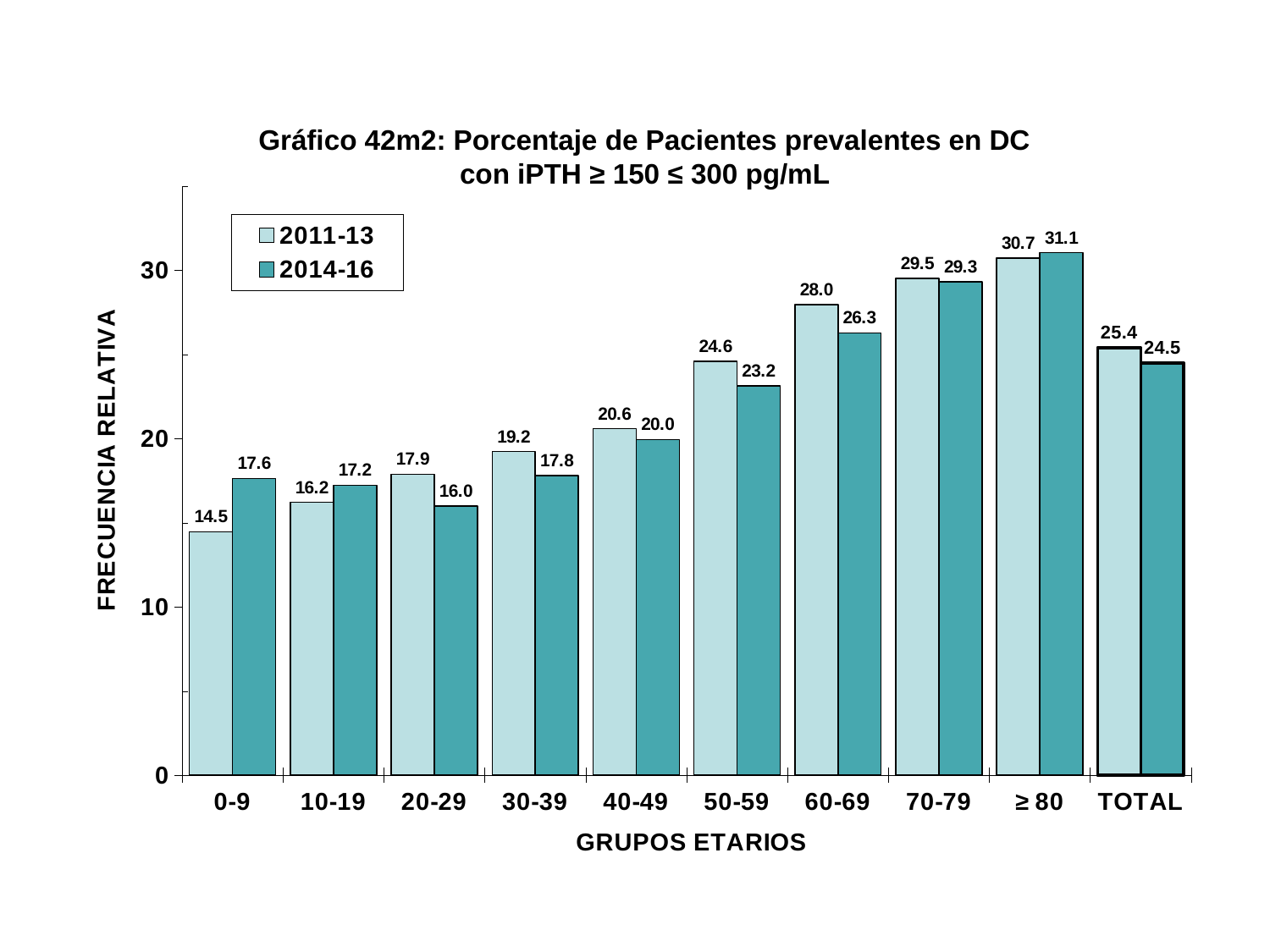
How many series does the legend list? 2 What is the value for the 2011-13 series in the 0-9 age group? 14.5 How many categories are shown on the x axis? 10 Is the 2014-16 value for the 40-49 age group greater or less than 10? greater What kind of chart is shown on the slide? bar chart What is the label of the y axis? FRECUENCIA RELATIVA Which age group has the lowest value for the 2011-13 series? 0-9 What is the TOTAL value for the 2014-16 series? 24.5 What is the difference between the 2011-13 and 2014-16 values in the 50-59 age group? 1.4 What is the value for the 2014-16 series in the 60-69 age group? 26.3 Which age group has the highest value for the 2014-16 series? ≥ 80 In the 20-29 age group, which series has the larger value, 2011-13 or 2014-16? 2011-13